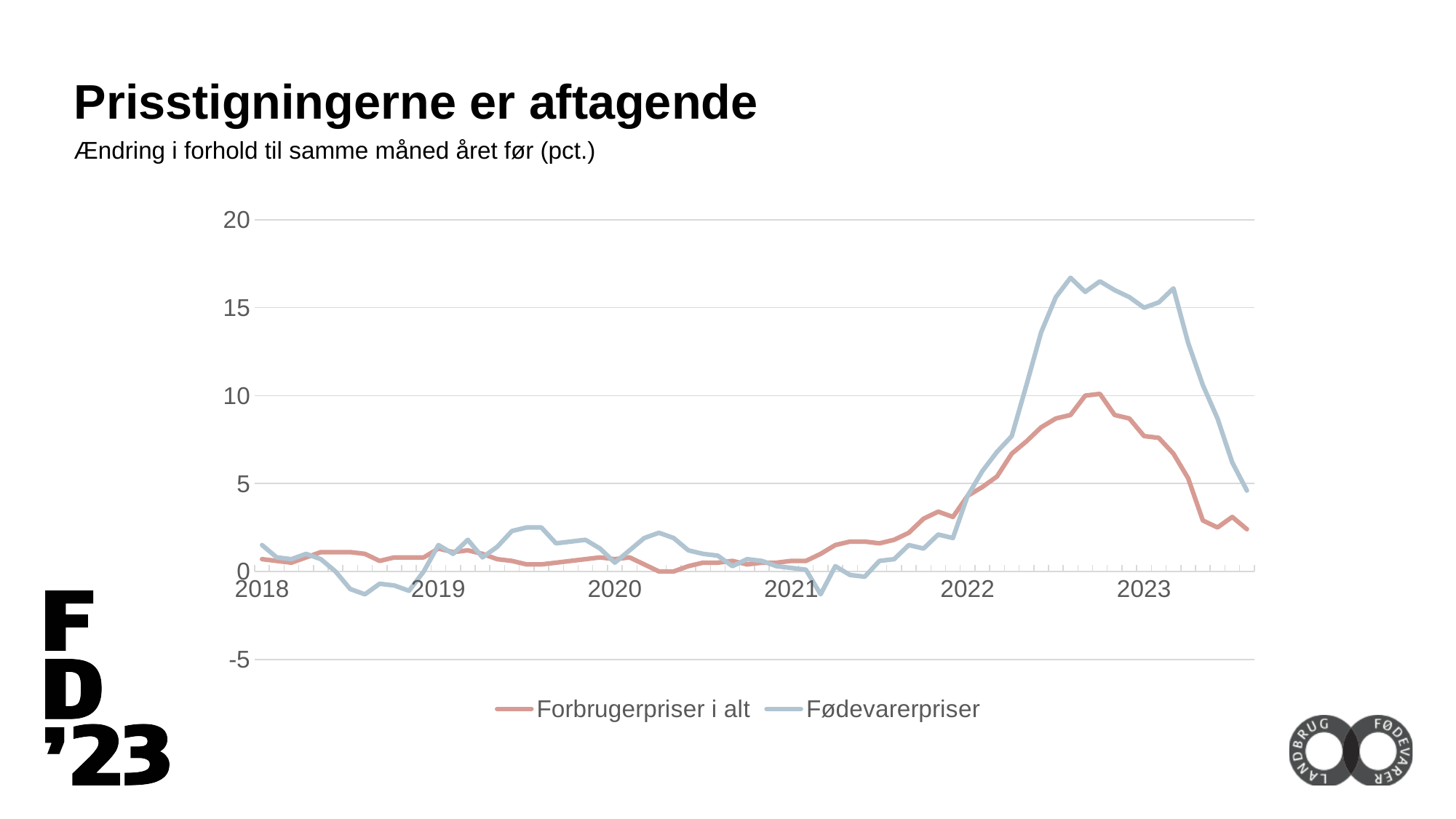
How many year labels are shown on the x axis? 6 What kind of chart is shown on the slide? line chart What are the two series named in the legend? Forbrugerpriser i alt and Fødevarerpriser Is the peak value of the Forbrugerpriser i alt line greater or less than 15? less Is the last plotted value of the Fødevarerpriser line greater or less than 10? less How many series does the legend list? 2 After their peaks in 2022–2023, do both lines rise or fall towards the end of the chart? fall Is the lowest value of the Fødevarerpriser line greater or less than 0? less Do the values of Forbrugerpriser i alt rise or fall between 2021 and 2022? rise Which series reaches the higher peak, Forbrugerpriser i alt or Fødevarerpriser? Fødevarerpriser What is the title of the slide above the chart? Prisstigningerne er aftagende